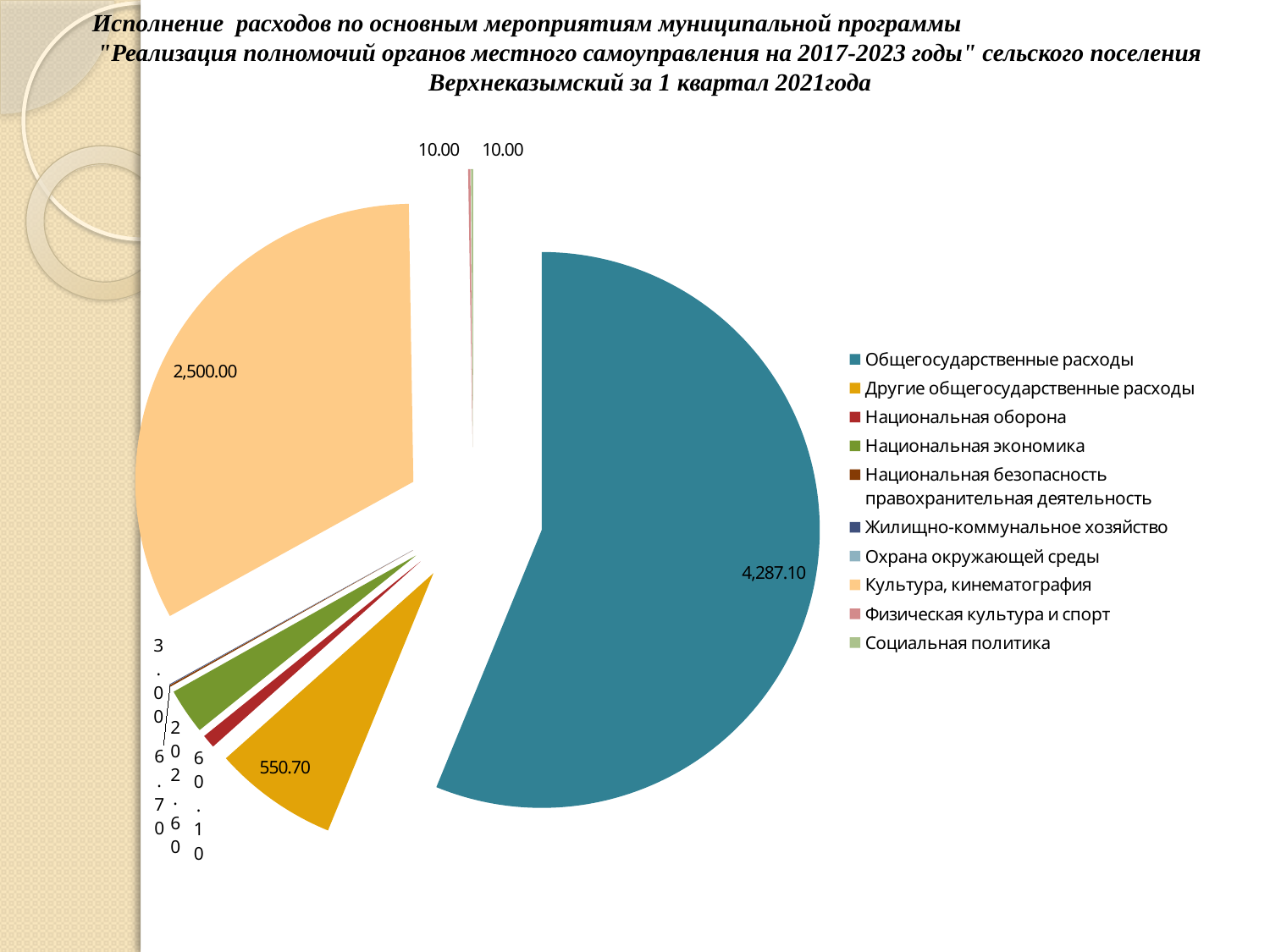
How many categories does the legend of the pie chart list? 10 What is the difference between the values for Общегосударственные расходы and Культура, кинематография? 1,787.10 What is the value shown for Другие общегосударственные расходы? 550.70 Which category has the largest slice of the pie? Общегосударственные расходы Which is larger: Культура, кинематография or Другие общегосударственные расходы? Культура, кинематография What colour is the slice for Общегосударственные расходы? teal (blue-green) What is the value shown for Общегосударственные расходы? 4,287.10 What is the difference between the values for Культура, кинематография and Другие общегосударственные расходы? 1,949.30 What is the value shown for Культура, кинематография? 2,500.00 What is the difference between the values for Общегосударственные расходы and Другие общегосударственные расходы? 3,736.40 Which category is listed last in the legend? Социальная политика What kind of chart is shown on the slide? pie chart